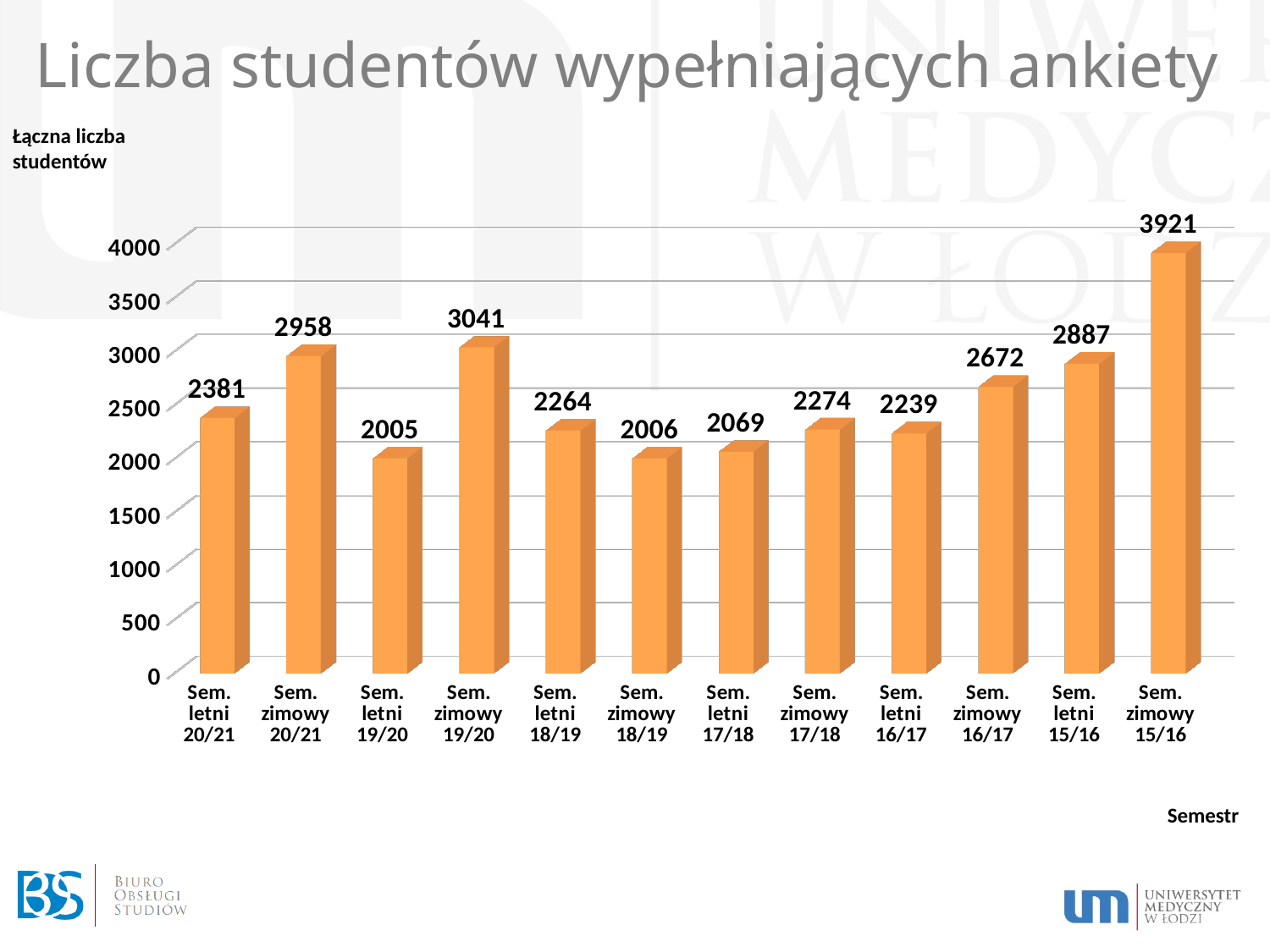
How many semesters are shown on the chart? 12 Which is larger, the value for Sem. zimowy 16/17 or Sem. letni 16/17? Sem. zimowy 16/17 What is the difference between the values for Sem. zimowy 20/21 and Sem. letni 20/21? 577 What kind of chart is shown on the slide? bar chart What is the value for Sem. letni 20/21? 2381 What is the value for Sem. zimowy 15/16? 3921 Is the value for Sem. zimowy 19/20 greater or less than 3000? greater Which semester has the lowest number of students? Sem. letni 19/20 Which semester has the highest number of students? Sem. zimowy 15/16 What is the value for Sem. zimowy 19/20? 3041 What is the title of the slide? Liczba studentów wypełniających ankiety What is the difference between the values for Sem. zimowy 15/16 and Sem. letni 15/16? 1034